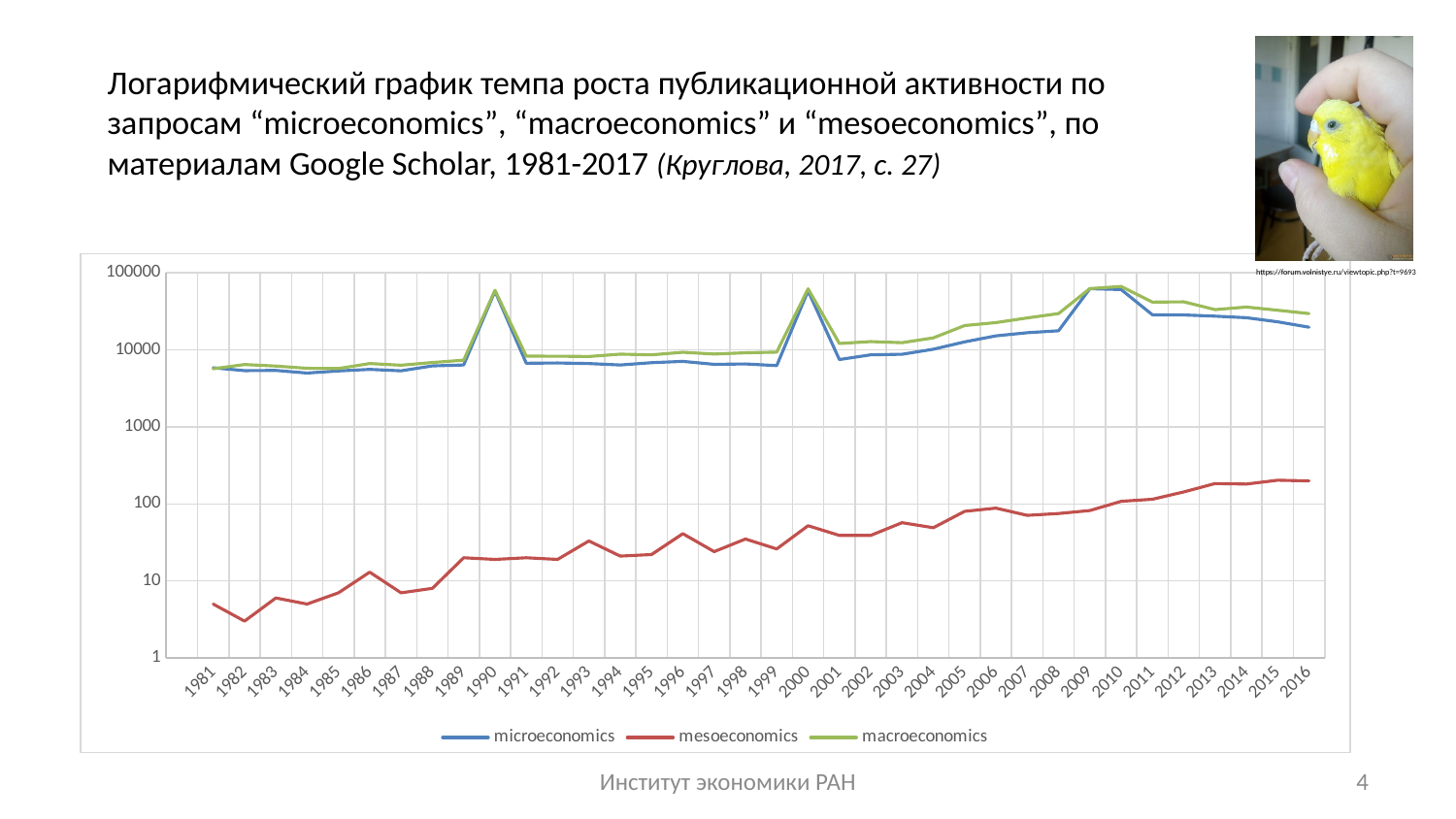
In 2016, which is larger: microeconomics or mesoeconomics? microeconomics Which colour is used for the macroeconomics series? green Is the value for microeconomics in 1981 greater or less than 10000? less Is the value for macroeconomics in 2016 greater or less than 10000? greater How many years are plotted along the x axis? 36 Which series has the lowest values across the whole period? mesoeconomics How many series does the legend list? 3 Is the value for mesoeconomics in 1981 greater or less than 10? less Does the mesoeconomics series generally rise or fall from 1981 to 2016? rise What kind of chart is shown on the slide? line chart In 2016, which is larger: macroeconomics or microeconomics? macroeconomics